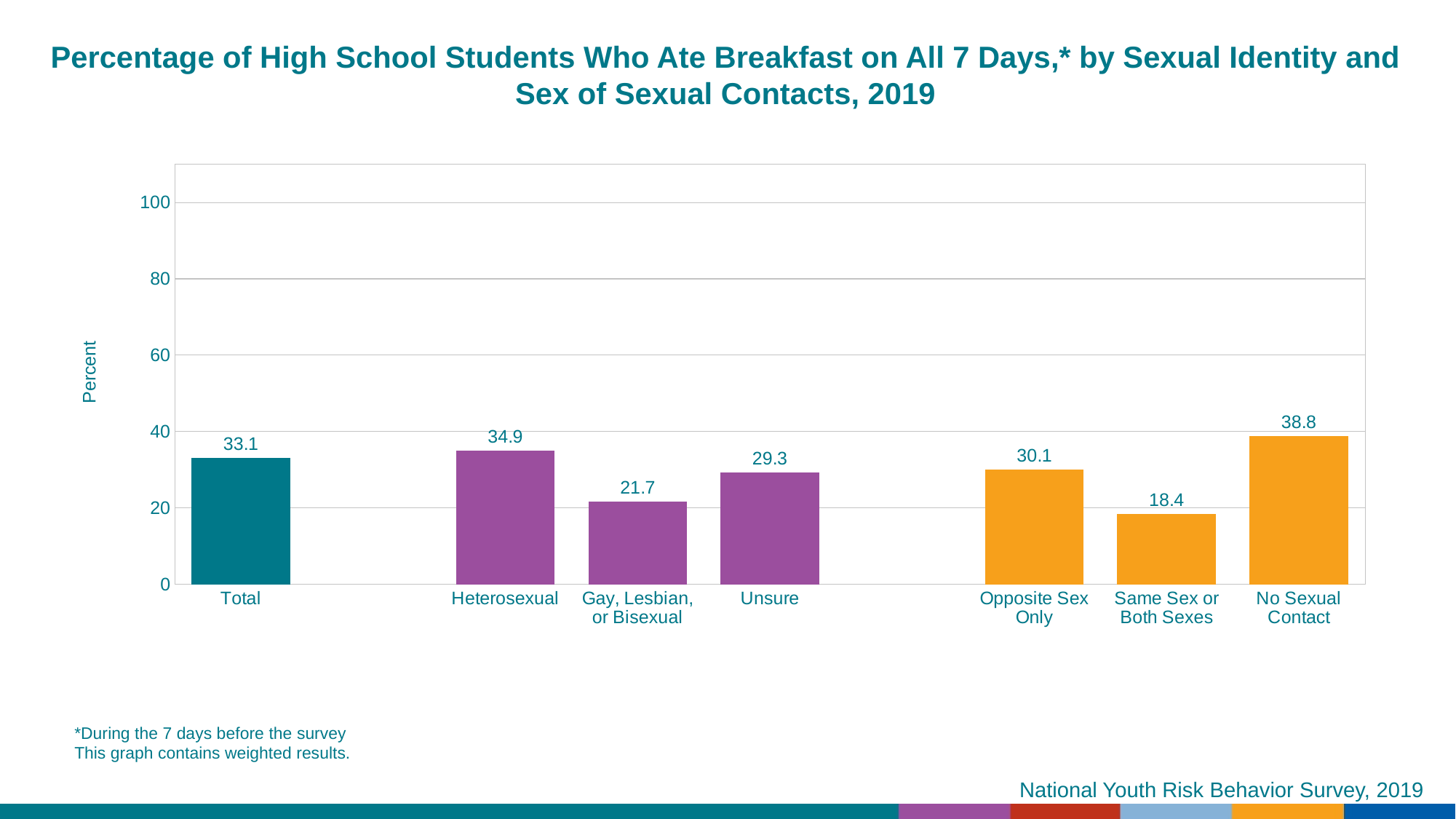
What kind of chart is this? bar chart Which category has the lowest value? Same Sex or Both Sexes What is the value for No Sexual Contact? 38.8 Is the value for Unsure greater or less than 40? less Which category has the highest value? No Sexual Contact What is the value for Total? 33.1 What is the difference between the values for Heterosexual and Unsure? 5.6 How many categories are shown on the x axis? 7 What is the difference between the values for Opposite Sex Only and Same Sex or Both Sexes? 11.7 Which is larger, the value for Heterosexual or the value for Total? Heterosexual What is the label of the y axis? Percent What is the value for Gay, Lesbian, or Bisexual students? 21.7